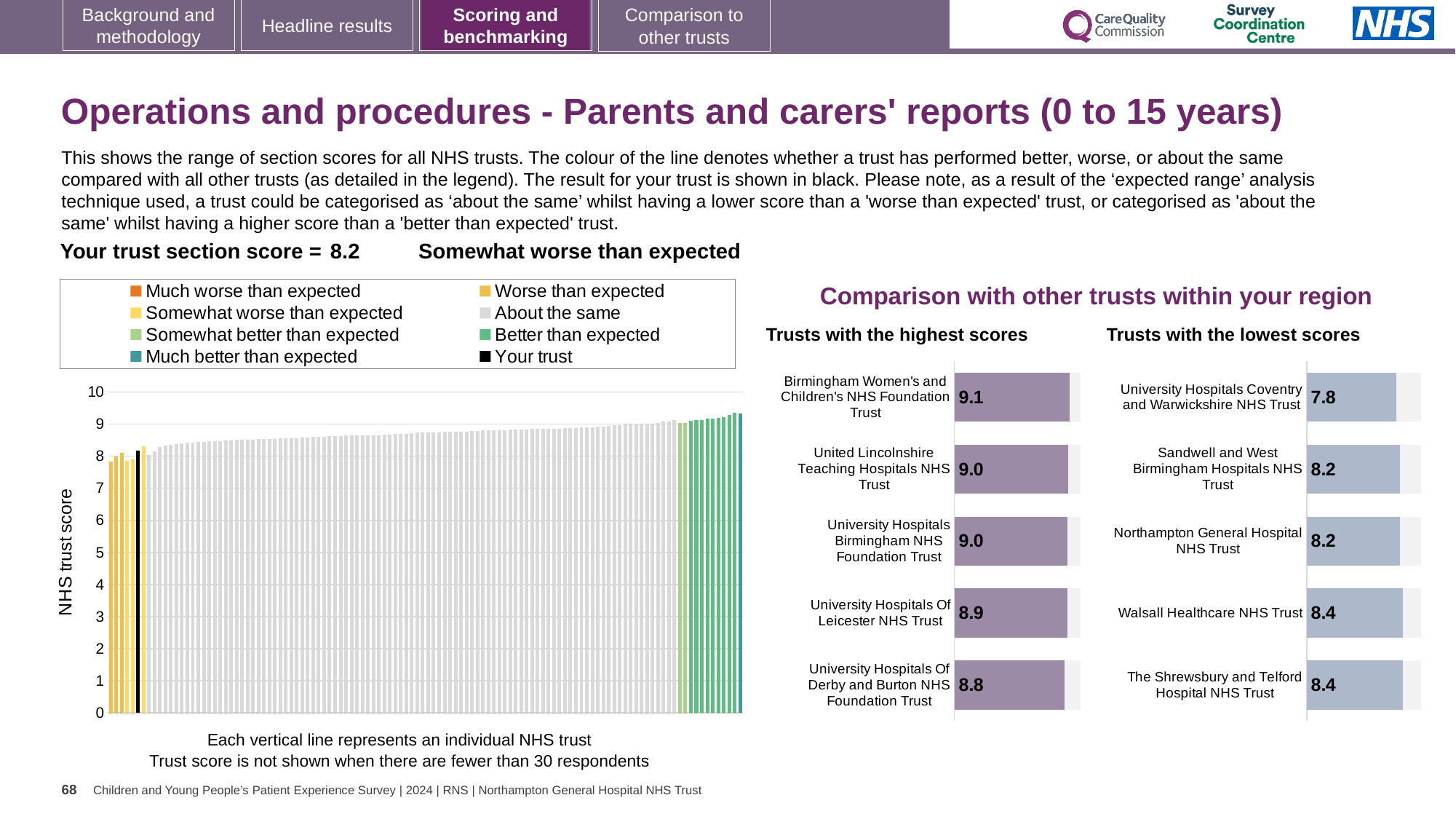
On the 'Trusts with the highest scores' chart, what is the difference between the scores of Birmingham Women's and Children's NHS Foundation Trust and University Hospitals Of Derby and Burton NHS Foundation Trust? 0.3 On the 'NHS trust score' chart, what colour represents 'Your trust'? black On the 'Trusts with the highest scores' chart, what is the score for Birmingham Women's and Children's NHS Foundation Trust? 9.1 On the 'Trusts with the lowest scores' chart, which has the larger score: Walsall Healthcare NHS Trust or University Hospitals Coventry and Warwickshire NHS Trust? Walsall Healthcare NHS Trust On the 'NHS trust score' chart, what is the section score for your trust? 8.2 On the 'Trusts with the highest scores' chart, which trust has the lowest score? University Hospitals Of Derby and Burton NHS Foundation Trust How many entries does the legend above the 'NHS trust score' chart list? 8 What kind of chart is the 'NHS trust score' chart on the left of the slide? bar chart How many trusts are shown on the 'Trusts with the highest scores' chart? 5 On the 'Trusts with the lowest scores' chart, which trust has the lowest score? University Hospitals Coventry and Warwickshire NHS Trust On the 'NHS trust score' chart, do the bars rise or fall from left to right? rise On the 'Trusts with the lowest scores' chart, what is the score for Walsall Healthcare NHS Trust? 8.4